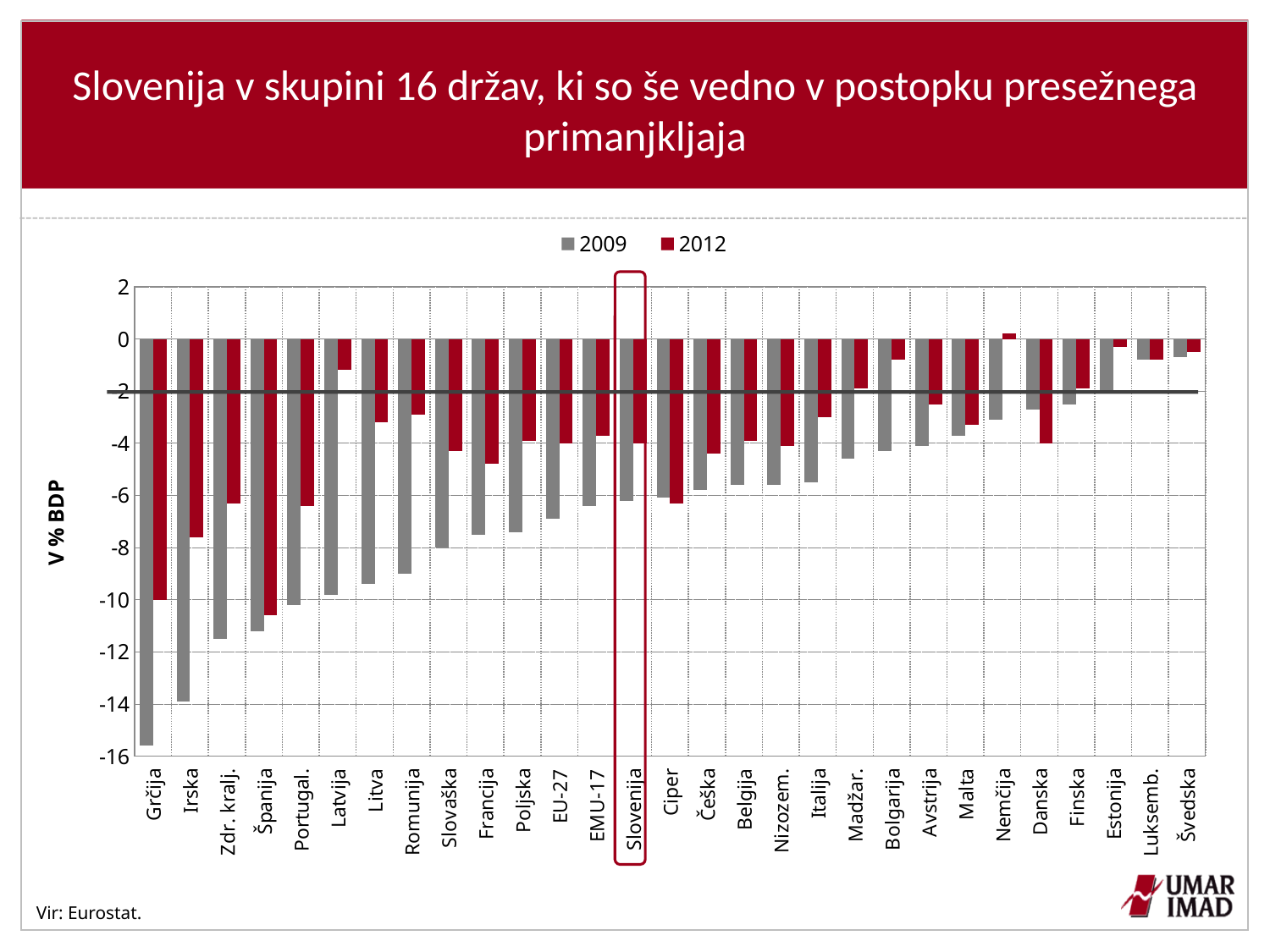
Is the 2009 value for Irska greater or less than -12? less Is the 2012 value for Latvija greater or less than -2? greater What kind of chart is shown on the slide? bar chart How many countries or groups are shown on the x axis? 29 Which category has the highest value for 2012? Nemčija Which category has the highest value for 2009? Švedska Is the 2009 value for Grčija greater or less than -14? less For Slovenija, which year has the larger (less negative) value, 2009 or 2012? 2012 What is the label of the vertical axis? V % BDP Which category has the lowest (most negative) value for 2009? Grčija How many series does the legend list? 2